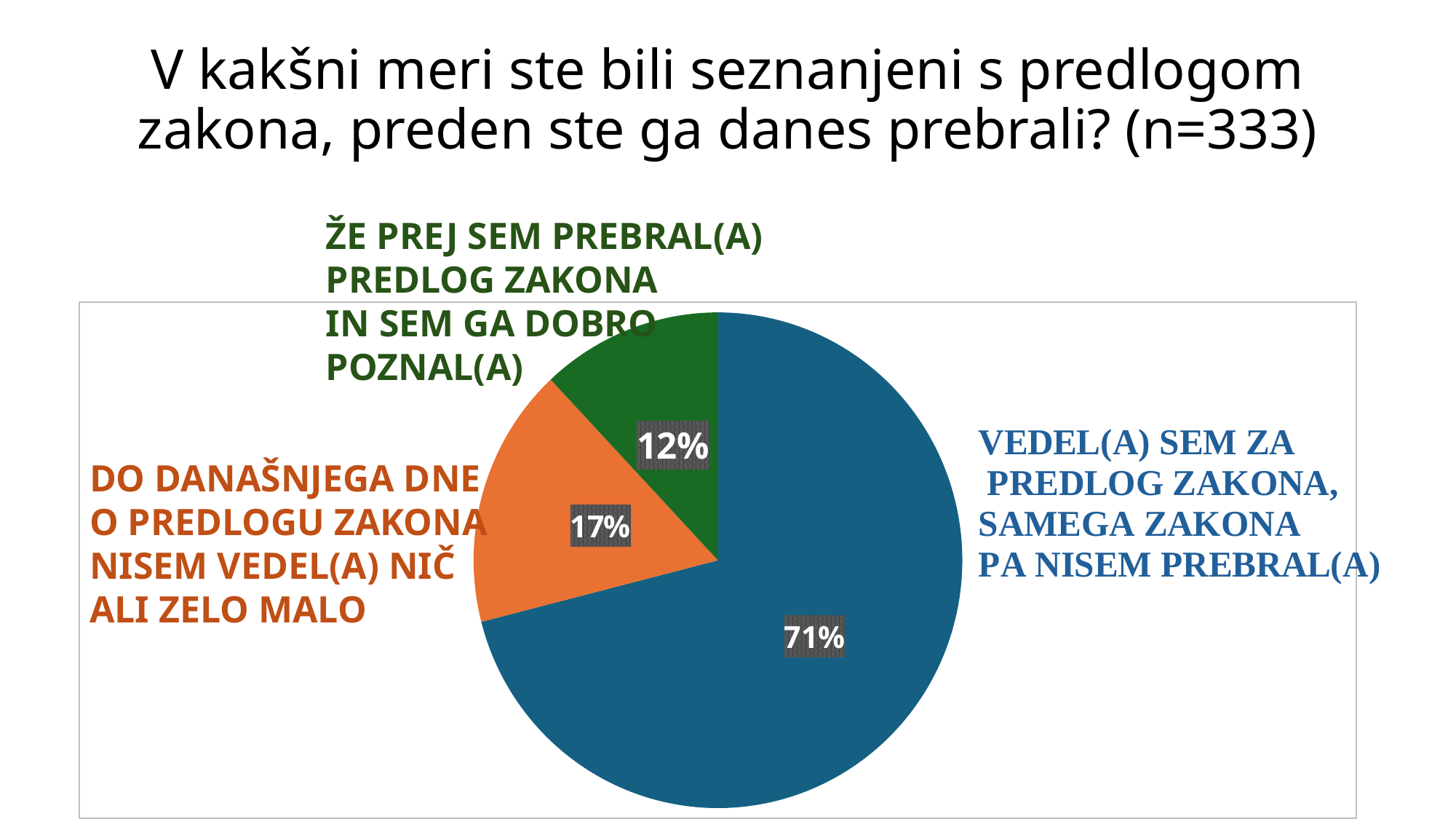
How many slices does the pie chart have? 3 What is the difference in percentage points between the orange slice (17%) and the green slice (12%)? 5 What is the difference in percentage points between the largest slice (71%) and the smallest slice (12%)? 59 What colour is the slice labelled 71%? blue Which is larger: the share for "Do današnjega dne o predlogu zakona nisem vedel(a) nič ali zelo malo" or the share for "Že prej sem prebral(a) predlog zakona in sem ga dobro poznal(a)"? Do današnjega dne o predlogu zakona nisem vedel(a) nič ali zelo malo What share of respondents answered "Vedel(a) sem za predlog zakona, samega zakona pa nisem prebral(a)"? 71% Which response category has the smallest slice of the pie? Že prej sem prebral(a) predlog zakona in sem ga dobro poznal(a) What share of respondents answered "Do današnjega dne o predlogu zakona nisem vedel(a) nič ali zelo malo"? 17% Which response category has the largest slice of the pie? Vedel(a) sem za predlog zakona, samega zakona pa nisem prebral(a) How many respondents (n) does the chart title state? 333 What share of respondents answered "Že prej sem prebral(a) predlog zakona in sem ga dobro poznal(a)"? 12% What kind of chart is shown on the slide? pie chart